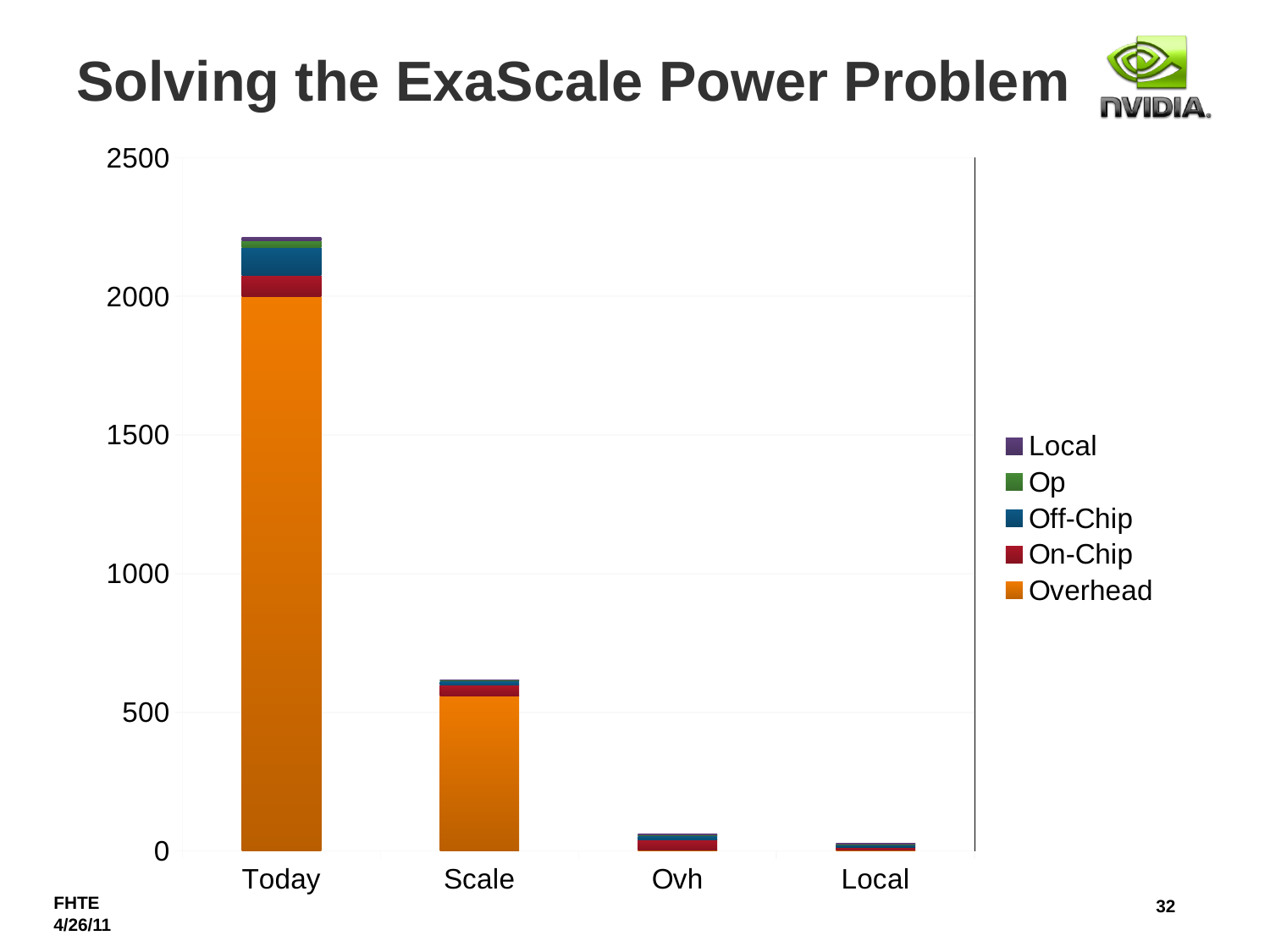
What kind of chart is shown on the slide? stacked bar chart Is the total for Scale greater or less than 500? greater Which stacked bar is taller, Scale or Ovh? Scale Is the total for Ovh greater or less than 500? less How many series does the chart's legend list? 5 Do the stacked bar totals rise or fall from Today to Local along the x axis? fall Which category has the shortest stacked bar? Local How many categories are shown along the x axis of the chart? 4 Is the total for Today greater or less than 2000? greater What is the title of the slide containing the chart? Solving the ExaScale Power Problem Which series is shown in orange in the chart's legend? Overhead Which category has the tallest stacked bar? Today